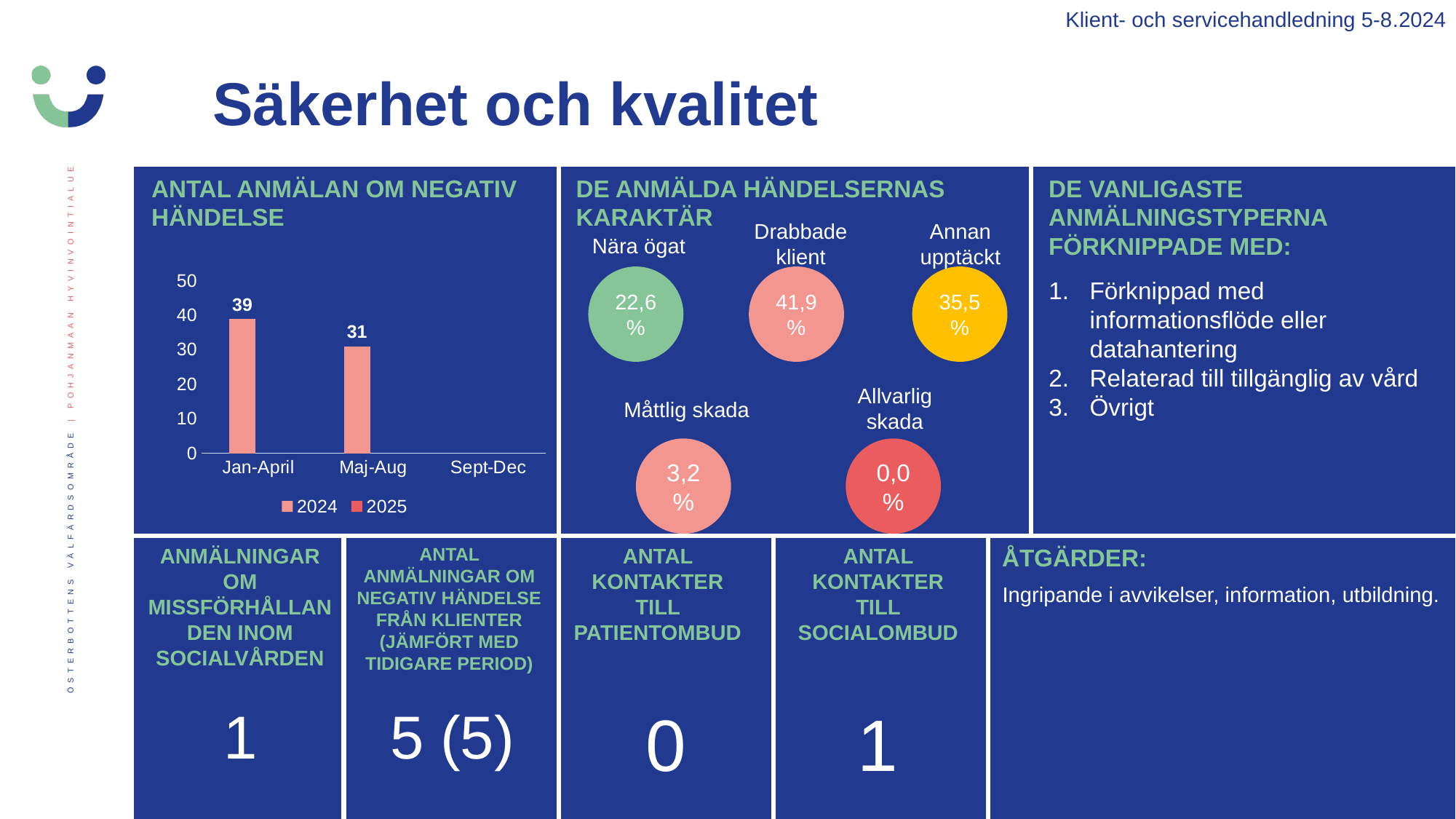
In the chart 'ANTAL ANMÄLAN OM NEGATIV HÄNDELSE', what is the value for Maj-Aug? 31 What are the two legend entries of the chart 'ANTAL ANMÄLAN OM NEGATIV HÄNDELSE'? 2024 and 2025 In the chart 'ANTAL ANMÄLAN OM NEGATIV HÄNDELSE', which is larger, Jan-April or Maj-Aug? Jan-April In the chart 'ANTAL ANMÄLAN OM NEGATIV HÄNDELSE', what is the difference between the Jan-April and Maj-Aug values? 8 What kind of chart is 'ANTAL ANMÄLAN OM NEGATIV HÄNDELSE'? bar chart How many period categories are shown on the x axis of the chart 'ANTAL ANMÄLAN OM NEGATIV HÄNDELSE'? 3 How many series does the legend of the chart 'ANTAL ANMÄLAN OM NEGATIV HÄNDELSE' list? 2 In the chart 'ANTAL ANMÄLAN OM NEGATIV HÄNDELSE', is the value for Maj-Aug greater or less than 40? less In the chart 'ANTAL ANMÄLAN OM NEGATIV HÄNDELSE', what is the value for Jan-April? 39 In the chart 'ANTAL ANMÄLAN OM NEGATIV HÄNDELSE', do the values rise or fall from Jan-April to Maj-Aug? fall In the chart 'ANTAL ANMÄLAN OM NEGATIV HÄNDELSE', which period has the highest bar? Jan-April In the chart 'ANTAL ANMÄLAN OM NEGATIV HÄNDELSE', is the value for Jan-April greater or less than 30? greater